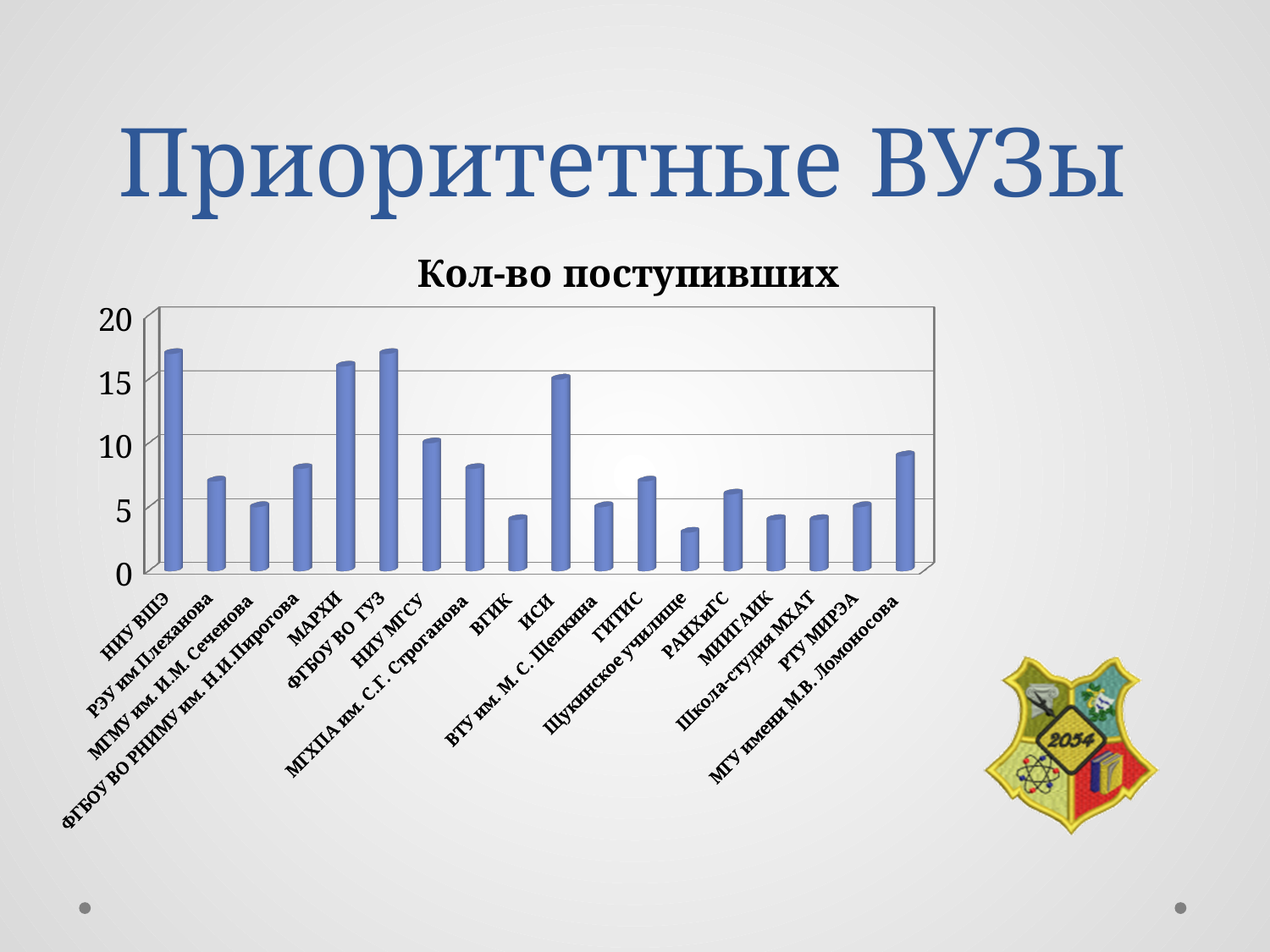
Is the value for НИУ ВШЭ greater or less than 15? greater Which university has the lowest value in the chart? Щукинское училище What kind of chart is shown on the slide? bar chart Is the value for МГУ имени М.В. Ломоносова greater or less than 10? less Is the value for Щукинское училище greater or less than 5? less Which has the larger value, МАРХИ or РЭУ им Плеханова? МАРХИ How many universities (categories) are shown on the x axis of the chart? 18 What is the title of the chart? Кол-во поступивших Which has the larger value, ИСИ or ГИТИС? ИСИ